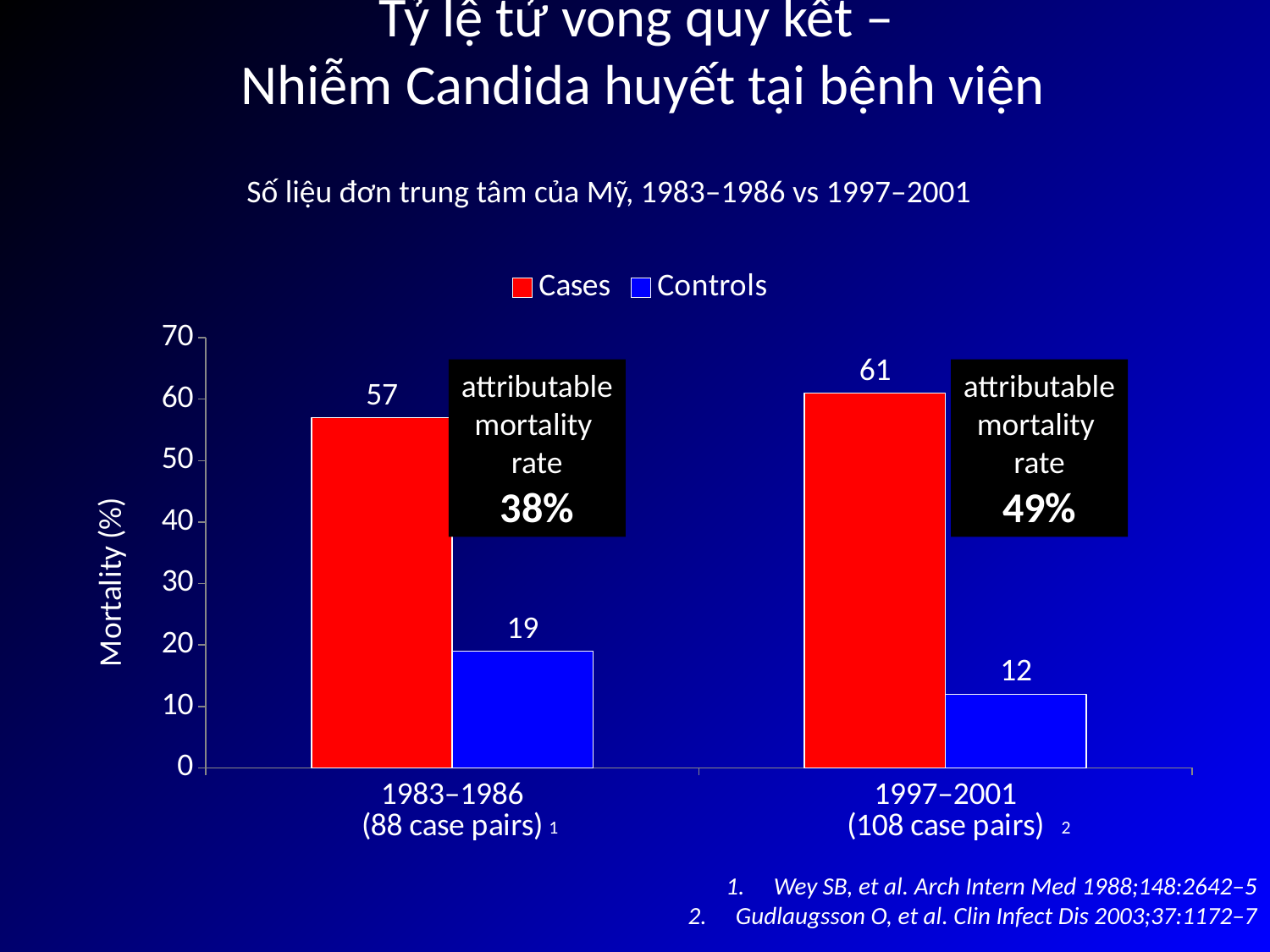
What attributable mortality rate is shown for the 1997–2001 period? 49% What is the difference between the Cases values for 1997–2001 and 1983–1986? 4 Which period has the highest Cases mortality value? 1997–2001 What kind of chart is shown on the slide? bar chart What is the mortality value for Controls in 1983–1986? 19 Is the Cases value for 1983–1986 greater or less than 50? greater Which is larger, the Controls value in 1983–1986 or the Controls value in 1997–2001? 1983–1986 What is the difference between the Cases and Controls values in 1997–2001? 49 How many series does the legend list? 2 What is the mortality value for Controls in 1997–2001? 12 Which period has the lowest Controls mortality value? 1997–2001 What is the mortality value for Cases in 1983–1986? 57